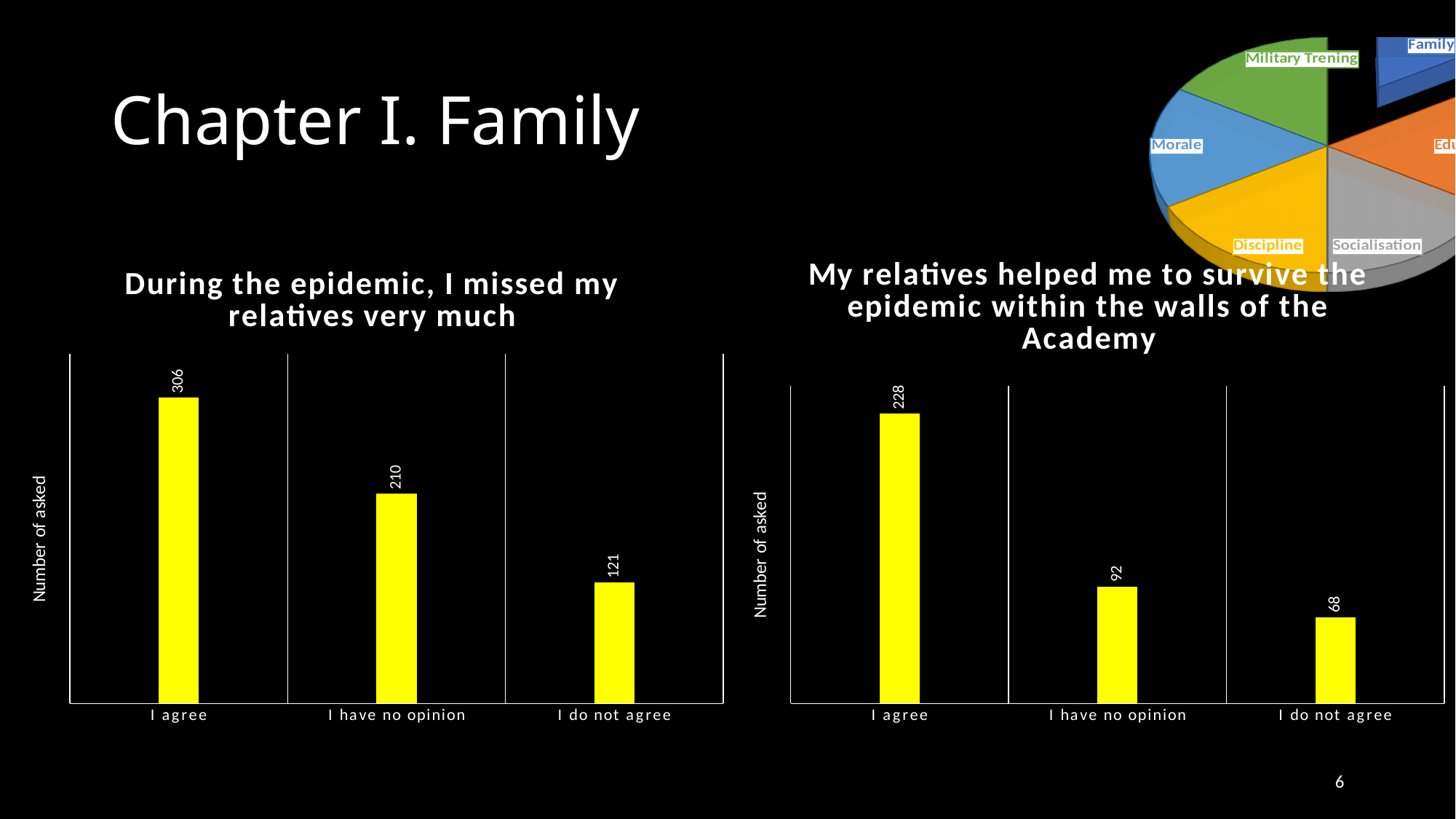
In the chart titled "My relatives helped me to survive the epidemic within the walls of the Academy", what is the difference between the values for "I agree" and "I have no opinion"? 136 Which is larger: the value for "I have no opinion" in the left chart or the value for "I have no opinion" in the right chart? The left chart (210) In the chart titled "During the epidemic, I missed my relatives very much", what is the difference between the values for "I agree" and "I do not agree"? 185 In the chart titled "During the epidemic, I missed my relatives very much", what is the value for "I have no opinion"? 210 How many categories are shown in the chart titled "During the epidemic, I missed my relatives very much"? 3 In the chart titled "My relatives helped me to survive the epidemic within the walls of the Academy", which category has the lowest value? I do not agree In the chart titled "During the epidemic, I missed my relatives very much", what is the value for "I do not agree"? 121 In the chart titled "During the epidemic, I missed my relatives very much", which category has the highest value? I agree In the chart titled "During the epidemic, I missed my relatives very much", what is the value for "I agree"? 306 In the chart titled "My relatives helped me to survive the epidemic within the walls of the Academy", what is the value for "I agree"? 228 What type of chart is used for "My relatives helped me to survive the epidemic within the walls of the Academy"? Bar chart In the chart titled "My relatives helped me to survive the epidemic within the walls of the Academy", what is the value for "I do not agree"? 68